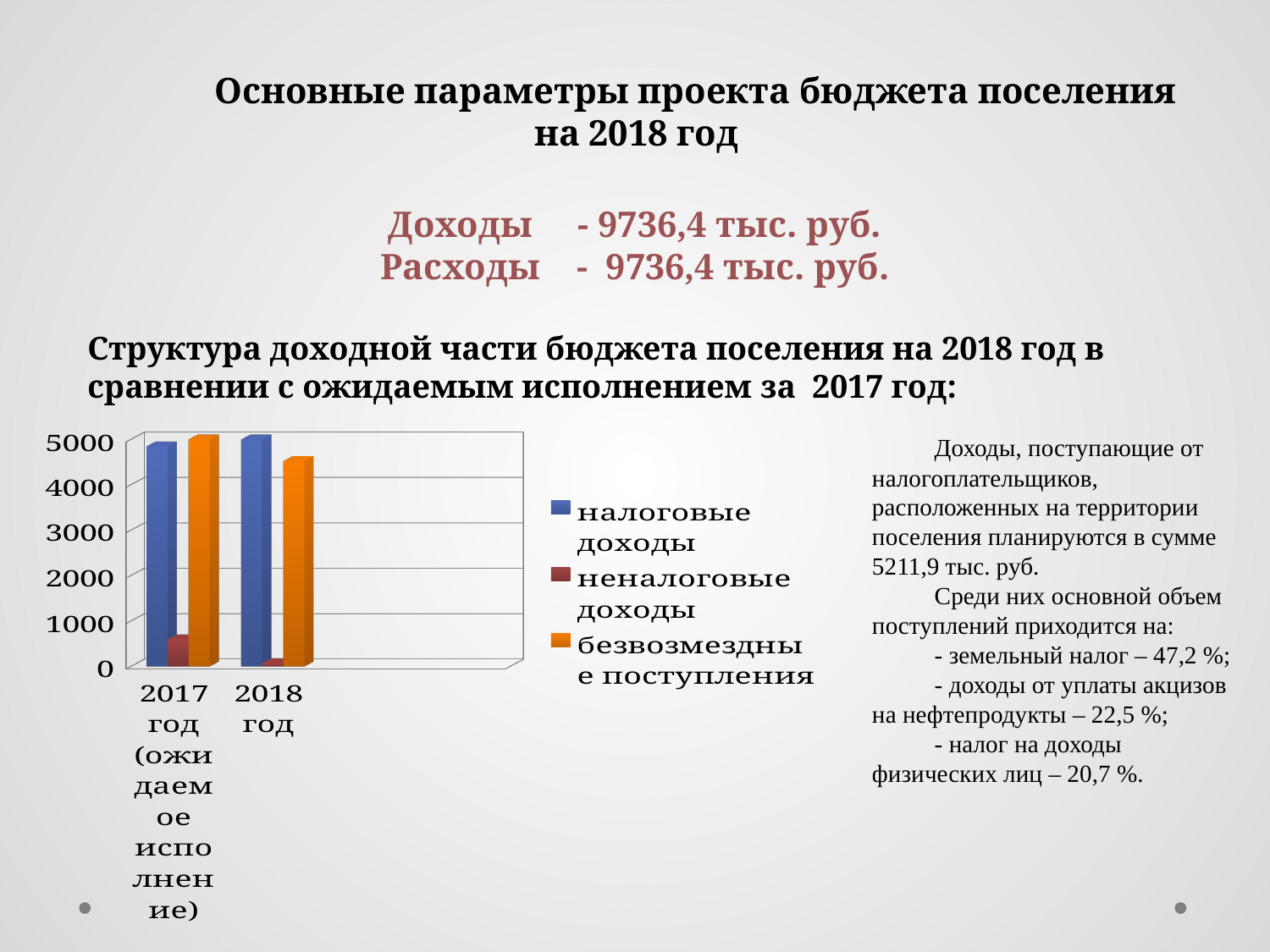
Which series has the lowest value for 2017 год (ожидаемое исполнение)? неналоговые доходы What kind of chart is shown on the slide? bar chart How many series does the chart legend list? 3 Which series has the lowest value for 2018 год? неналоговые доходы Do the values of неналоговые доходы rise or fall from 2017 год to 2018 год? fall How many categories (years) are shown on the x axis of the chart? 2 Which is larger: безвозмездные поступления for 2017 год or for 2018 год? 2017 год Which is larger: неналоговые доходы for 2017 год or for 2018 год? 2017 год What colour represents налоговые доходы in the chart? blue Is the value of налоговые доходы for 2017 год greater or less than 4000? greater Is the value of неналоговые доходы for 2017 год greater or less than 1000? less Is the value of безвозмездные поступления for 2018 год greater or less than 4000? greater